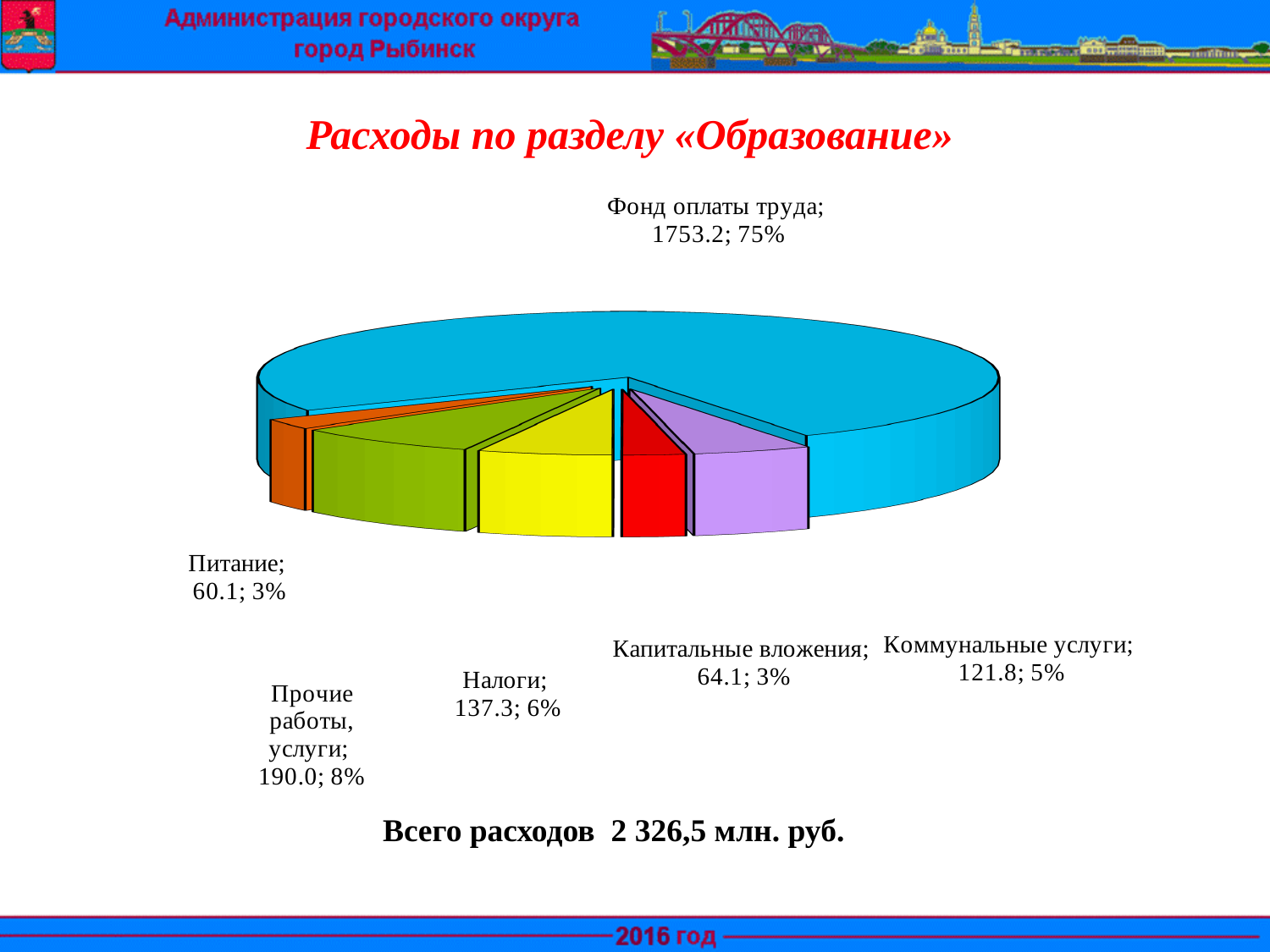
Which category has the smallest value? Питание What is the title of the chart? Расходы по разделу «Образование» What share of the pie does Фонд оплаты труда take? 75% What is the value for Прочие работы, услуги? 190.0 What is the value for Коммунальные услуги? 121.8 What share of the pie does Налоги take? 6% Which is larger, the value for Капитальные вложения or the value for Питание? Капитальные вложения Which category has the largest value? Фонд оплаты труда What kind of chart is shown on the slide? pie chart How many categories does the pie chart have? 6 What is the difference between the values for Прочие работы, услуги and Налоги? 52.7 What is the value for Фонд оплаты труда? 1753.2